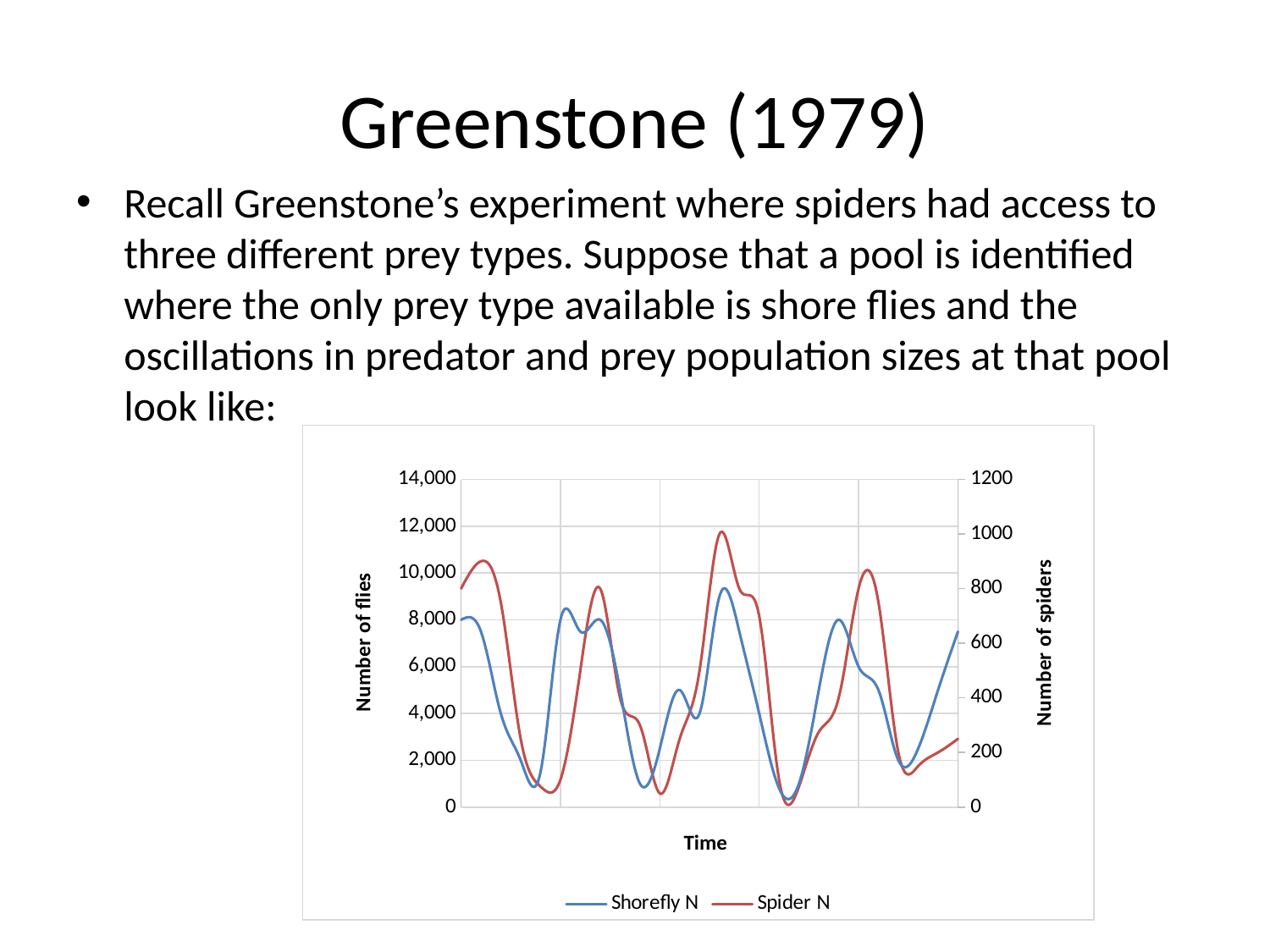
How many series does the chart's legend list? 2 What kind of chart is shown on the slide? line chart What are the two series named in the chart's legend? Shorefly N and Spider N Is the highest peak of the Shorefly N line greater or less than 8,000 on the left axis? greater Is the lowest point of the Spider N line greater or less than 200 on the right axis? less Does the Shorefly N line rise steadily, fall steadily, or oscillate along the Time axis? oscillate Is the lowest point of the Shorefly N line greater or less than 2,000 on the left axis? less What is the title of the chart's horizontal axis? Time What is the highest tick value shown on the left vertical axis (Number of flies)? 14,000 Which series is plotted against the right-hand axis labelled Number of spiders? Spider N What is the highest tick value shown on the right vertical axis (Number of spiders)? 1200